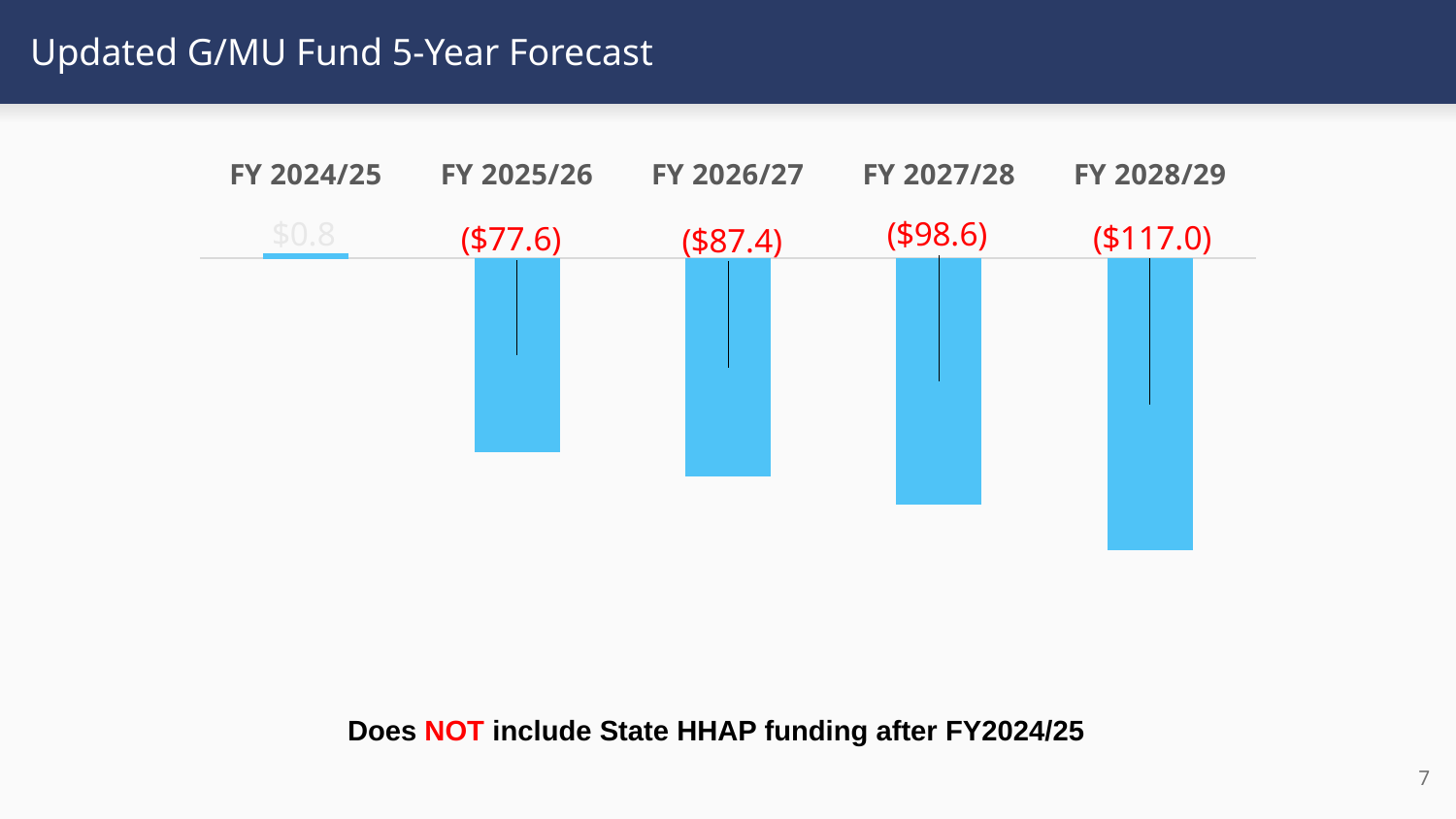
Which is larger, the value for FY 2025/26 or the value for FY 2027/28? FY 2025/26 Do the values rise or fall from FY 2024/25 to FY 2028/29? Fall What is the value shown for FY 2024/25? $0.8 What is the value shown for FY 2026/27? ($87.4) What is the value shown for FY 2028/29? ($117.0) Which fiscal year has the highest value in the chart? FY 2024/25 How many fiscal years are shown in the chart? 5 How much larger is the deficit for FY 2028/29 than for FY 2025/26? $39.4 What is the value shown for FY 2027/28? ($98.6) What is the difference between the values for FY 2027/28 and FY 2026/27? $11.2 Which fiscal year has the lowest value in the chart? FY 2028/29 What is the value shown for FY 2025/26? ($77.6)